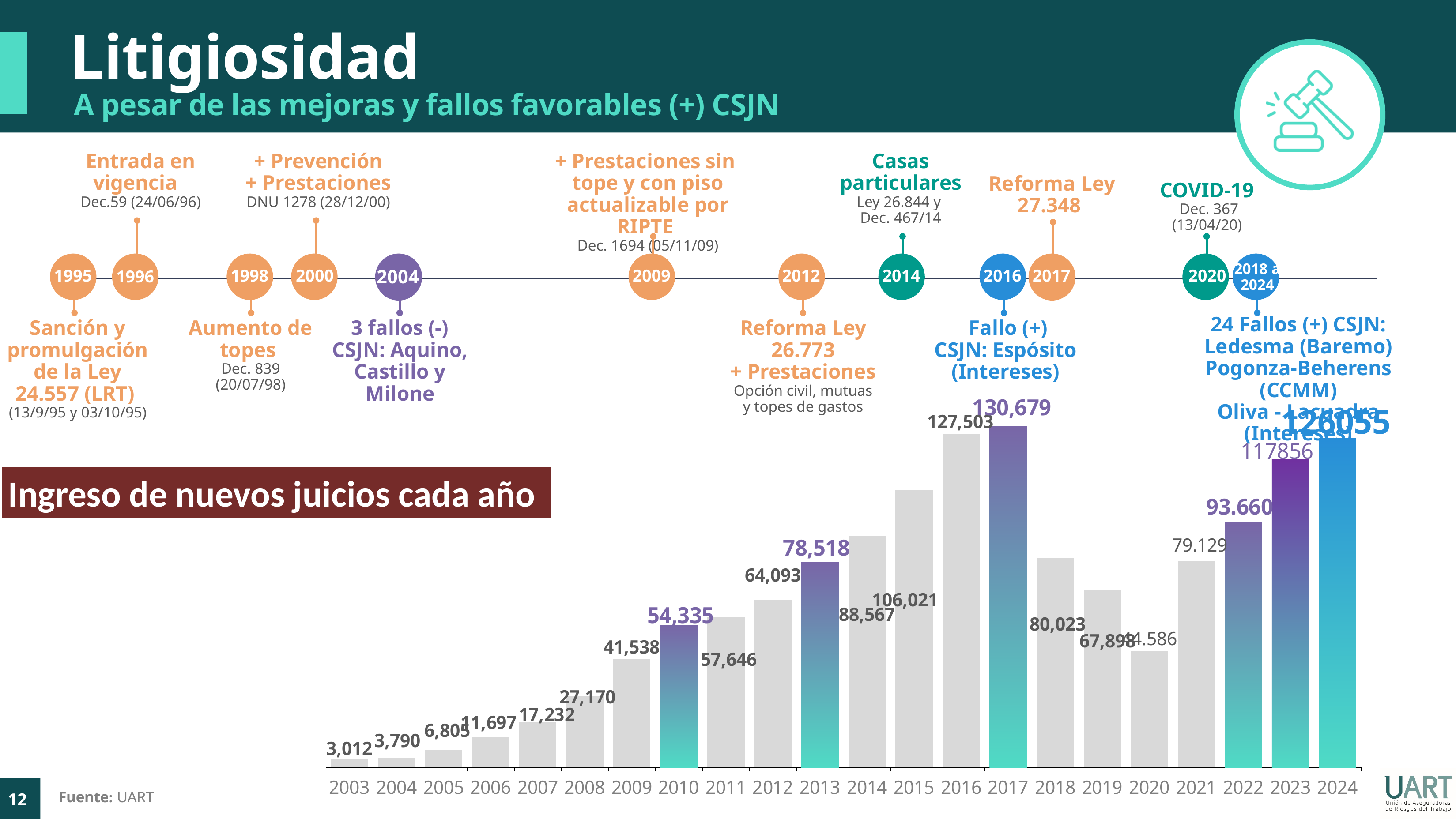
What is the value for 2022 in the 'Ingreso de nuevos juicios cada año' chart? 93.660 In the 'Ingreso de nuevos juicios cada año' chart, do the values rise or fall from 2003 to 2017? Rise What kind of chart is 'Ingreso de nuevos juicios cada año'? Bar chart In the 'Ingreso de nuevos juicios cada año' chart, which is larger, the value for 2015 or the value for 2014? 2015 What is the value for 2017 in the 'Ingreso de nuevos juicios cada año' chart? 130,679 What is the value for 2010 in the 'Ingreso de nuevos juicios cada año' chart? 54,335 How many years are shown on the x axis of the 'Ingreso de nuevos juicios cada año' chart? 22 Which year has the highest value in the 'Ingreso de nuevos juicios cada año' chart? 2017 In the 'Ingreso de nuevos juicios cada año' chart, what is the difference between the values for 2016 and 2015? 21,482 In the 'Ingreso de nuevos juicios cada año' chart, what is the difference between the values for 2017 and 2016? 3,176 Which year has the lowest value in the 'Ingreso de nuevos juicios cada año' chart? 2003 What is the value for 2016 in the 'Ingreso de nuevos juicios cada año' chart? 127,503